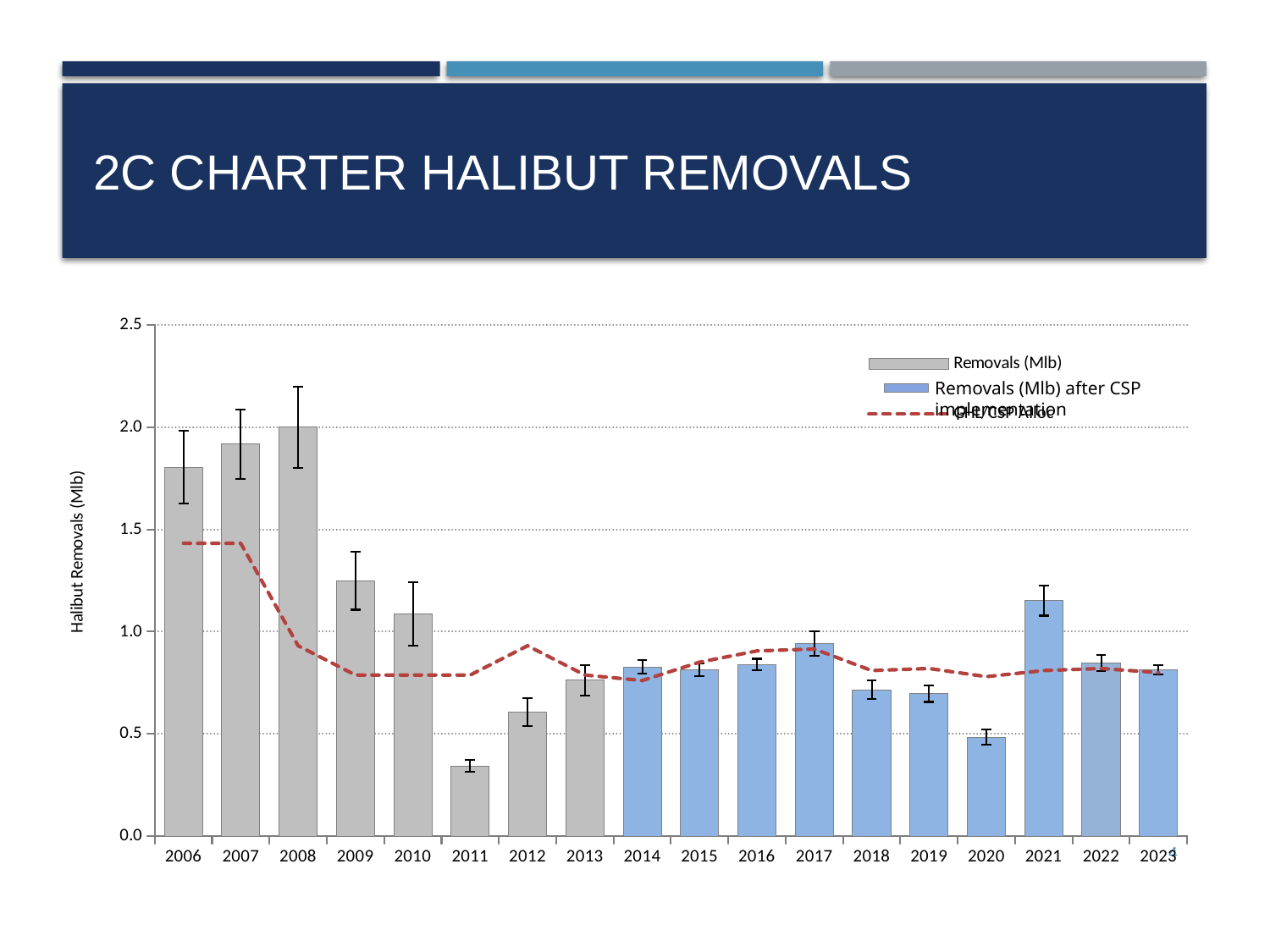
Do the halibut removals rise or fall from 2006 to 2011? fall Is the value for 2006 greater or less than 1.5? greater How many years are shown on the x axis of the chart? 18 Is the value for 2009 greater or less than 1.0? greater What is the label on the y axis of the chart? Halibut Removals (Mlb) Is the value for 2011 greater or less than 0.5? less What kind of chart is shown on the slide? combination bar and line chart How many series does the chart legend list? 3 Which year has the larger halibut removals bar, 2006 or 2010? 2006 Which year has the highest halibut removals bar? 2008 Which year has the lowest halibut removals bar? 2011